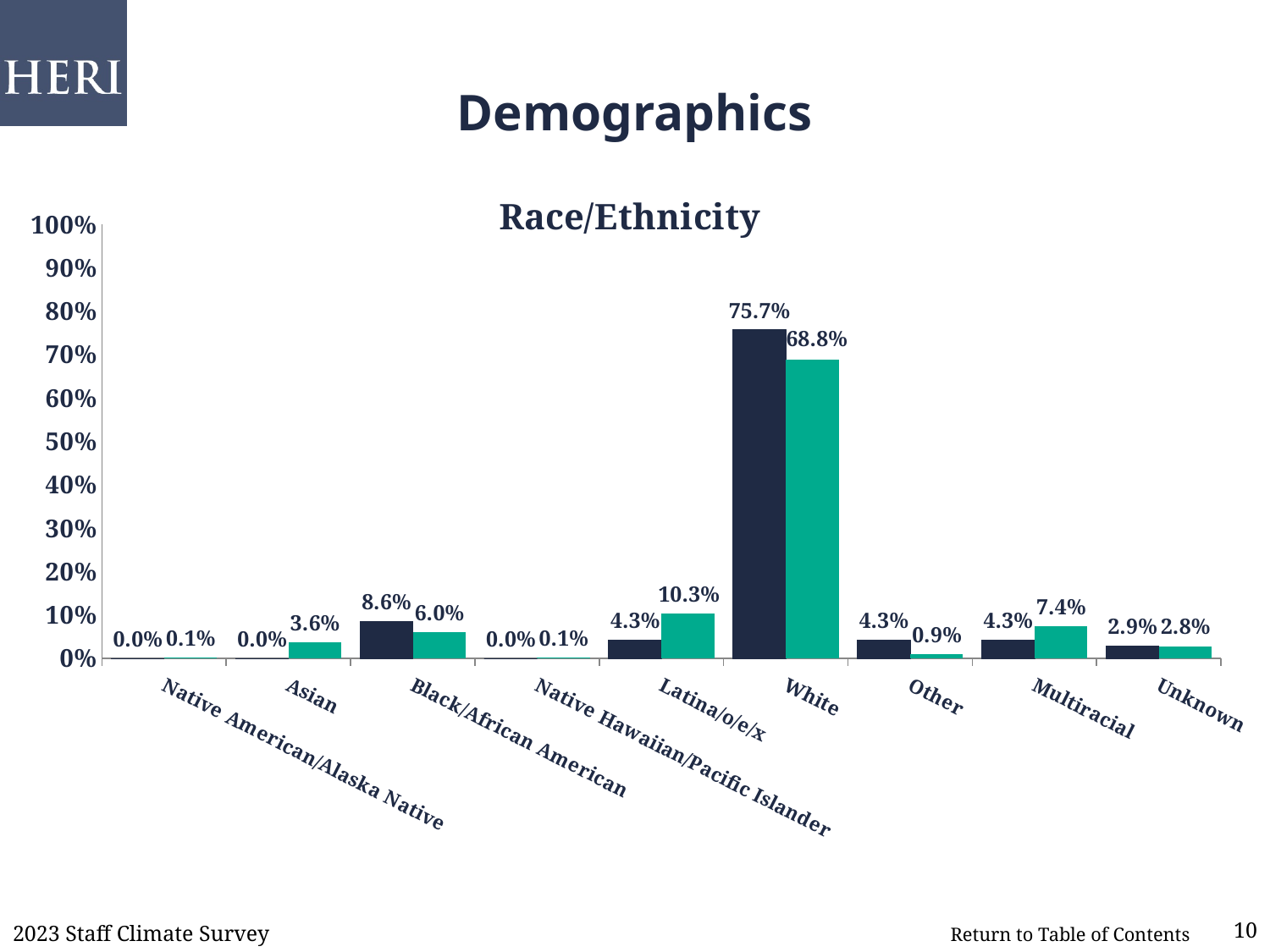
What is the difference between the dark navy and teal bars for White? 6.9% How many race/ethnicity categories are shown on the x axis? 9 What is the difference between the teal and dark navy bars for Multiracial? 3.1% What kind of chart is shown on the slide? bar chart What is the value of the teal bar for Latina/o/e/x? 10.3% Is the teal bar for White greater or less than 70%? less What is the value of the dark navy bar for White? 75.7% What is the value of the dark navy bar for Black/African American? 8.6% For Other, which bar is larger, the dark navy bar or the teal bar? the dark navy bar What is the title of the chart? Race/Ethnicity Which category has the highest value for the teal bars? White What is the value of the teal bar for Asian? 3.6%